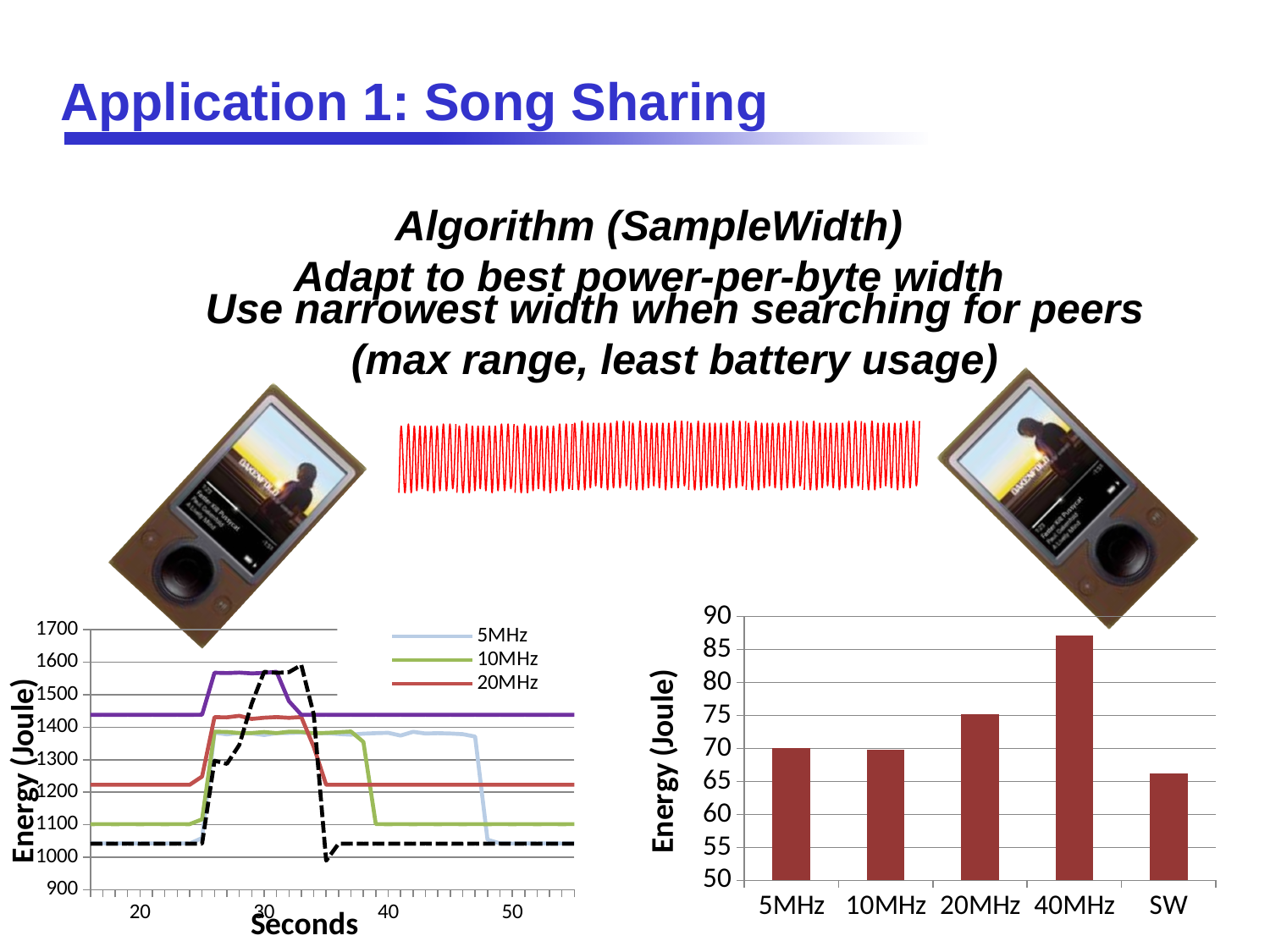
What kind of chart is the chart on the right of the slide? bar chart In the line chart on the left, is the 20MHz value at 20 seconds greater or less than 1200? greater What kind of chart is the chart on the left of the slide? line chart In the bar chart on the right, is the value for 40MHz greater or less than 85? greater In the bar chart on the right, which category has the lowest energy? SW In the bar chart on the right, is the value for SW greater or less than 70? less In the bar chart on the right, which category has the highest energy? 40MHz In the line chart on the left, what is the label of the x axis? Seconds In the bar chart on the right, how many categories are shown on the x axis? 5 In the line chart on the left, how many series does the legend list? 3 In the bar chart on the right, which is larger, the value for 20MHz or the value for SW? 20MHz